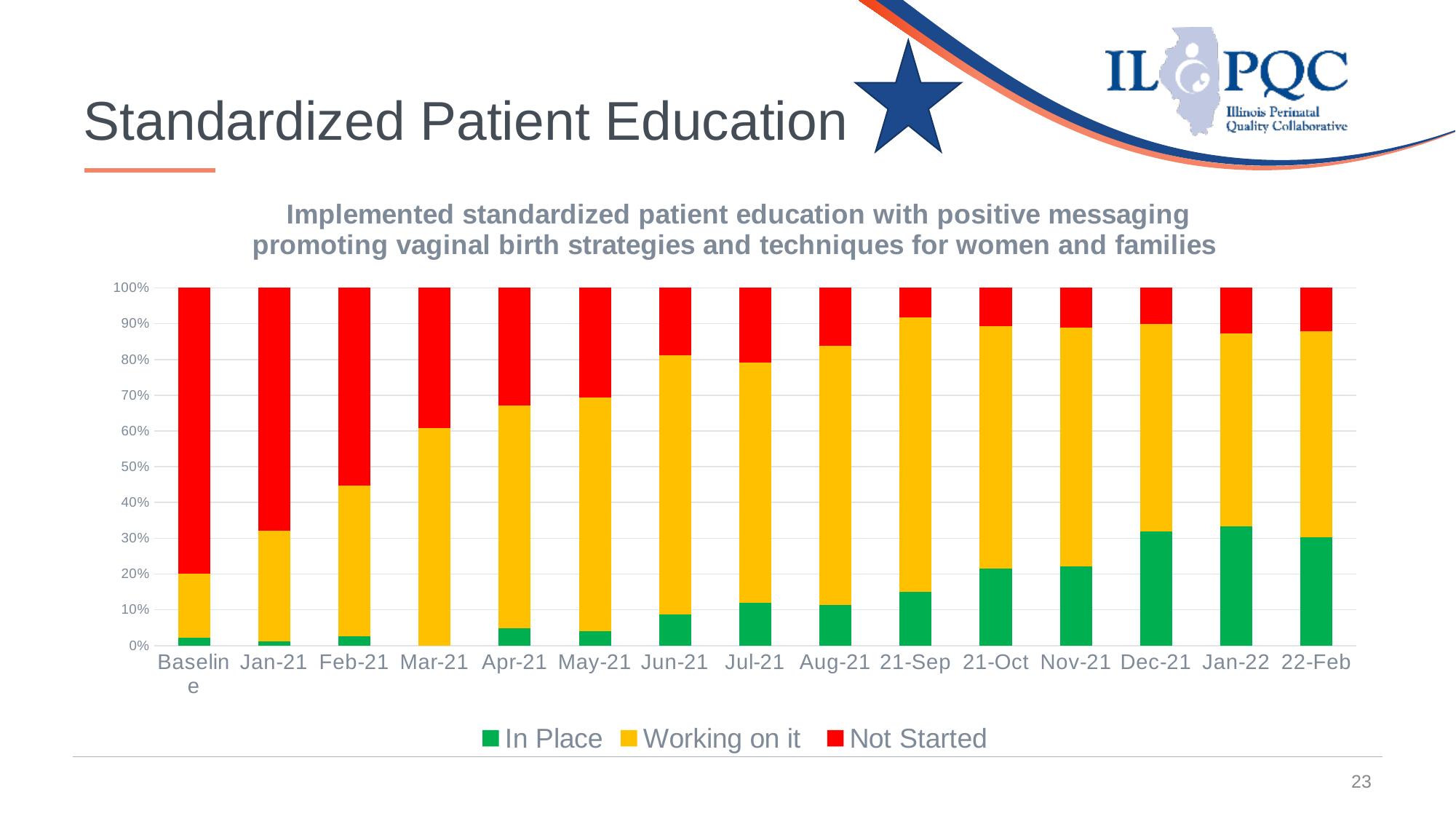
Is the 'In Place' value for Dec-21 greater or less than 20%? greater Is the 'Not Started' value for Baseline greater or less than 70%? greater Which series is shown in green in the legend? In Place Which series is shown in red in the legend? Not Started Does the 'Not Started' share generally rise or fall from Baseline to 22-Feb? Fall How many time periods (categories) are shown along the x axis? 15 Is the 'Working on it' value for Mar-21 greater or less than 50%? greater What kind of chart is shown on the slide? Stacked bar chart Which is larger, the 'In Place' share for Dec-21 or for Jun-21? Dec-21 How many series does the legend list? 3 In which period is the 'Not Started' share the highest? Baseline